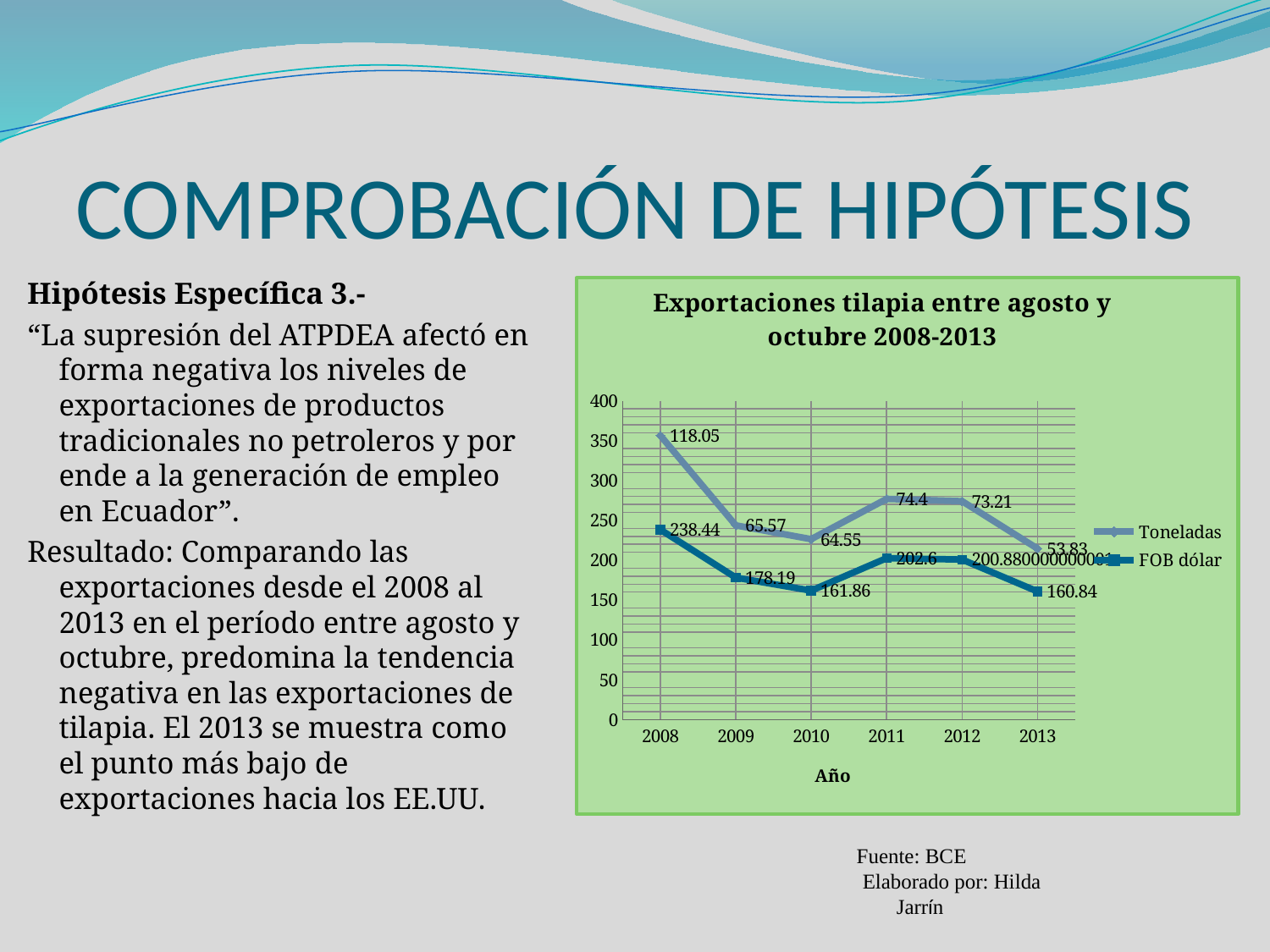
How many years are plotted along the x axis of the chart? 6 How many series does the legend of the chart list? 2 What is the difference between the Toneladas values for 2008 and 2009? 52.48 What is the FOB dólar value for 2010? 161.86 In which year is the FOB dólar value highest? 2008 What kind of chart is shown on the slide? line chart In which year is the Toneladas value lowest? 2013 In which year is the Toneladas value highest? 2008 What is the Toneladas value for 2008? 118.05 What is the Toneladas value for 2013? 53.83 Which year has the larger FOB dólar value, 2010 or 2011? 2011 What is the title of the x axis of the chart? Año